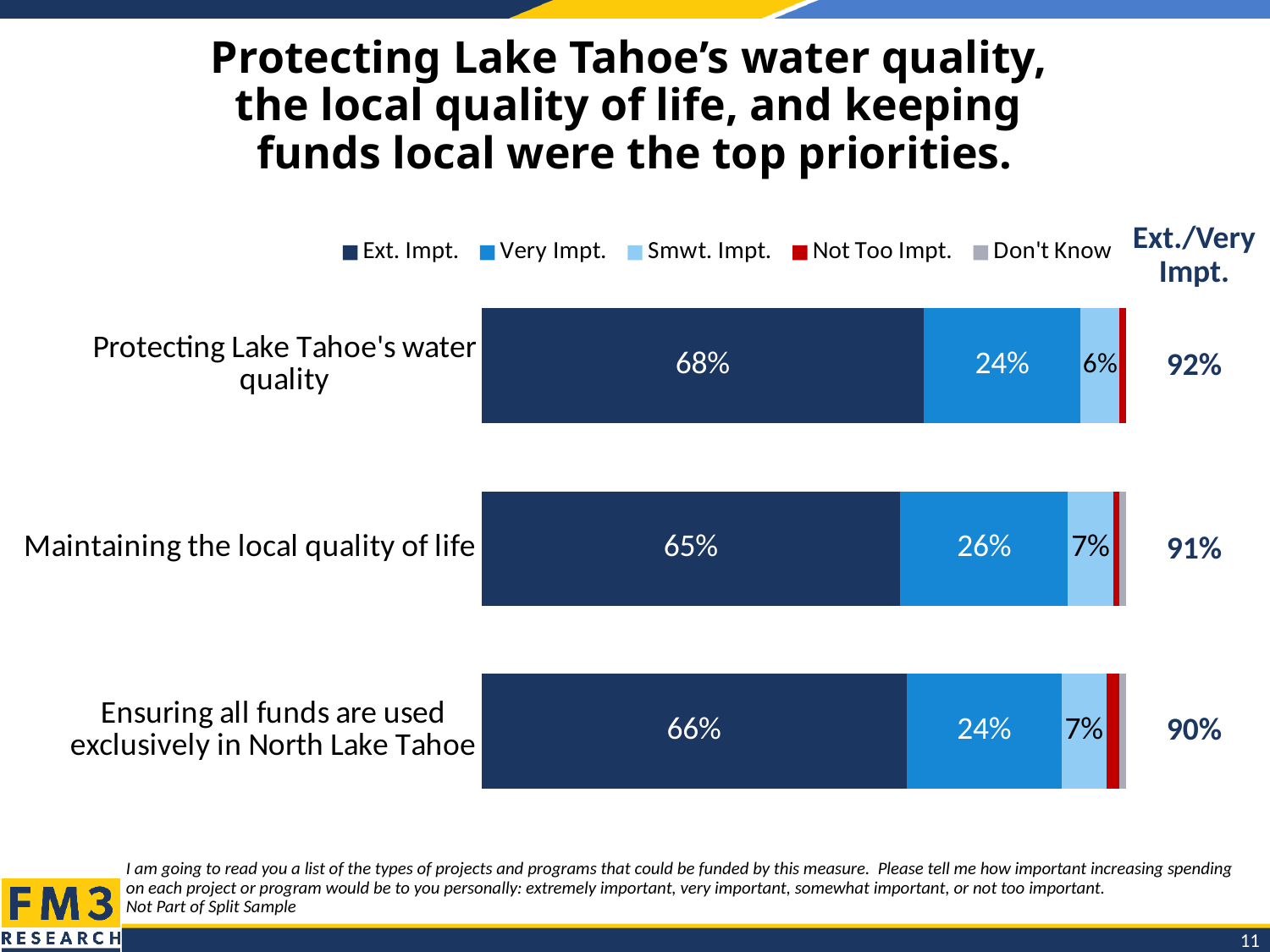
What is the Smwt. Impt. value for 'Ensuring all funds are used exclusively in North Lake Tahoe'? 7% How many categories are shown in the chart? 3 What percentage of respondents rated 'Protecting Lake Tahoe's water quality' as Ext. Impt.? 68% Which is larger: the Very Impt. value for 'Maintaining the local quality of life' or for 'Ensuring all funds are used exclusively in North Lake Tahoe'? Maintaining the local quality of life Which category has the highest Ext. Impt. value? Protecting Lake Tahoe's water quality What is the combined Ext./Very Impt. figure shown for 'Maintaining the local quality of life'? 91% How many series does the legend list? 5 What is the Very Impt. value for 'Maintaining the local quality of life'? 26% What kind of chart is shown on the slide? Stacked bar chart Which category has the lowest Ext. Impt. value? Maintaining the local quality of life What is the difference between the Ext. Impt. values for 'Protecting Lake Tahoe's water quality' and 'Maintaining the local quality of life'? 3% Which legend entry is shown in red? Not Too Impt.